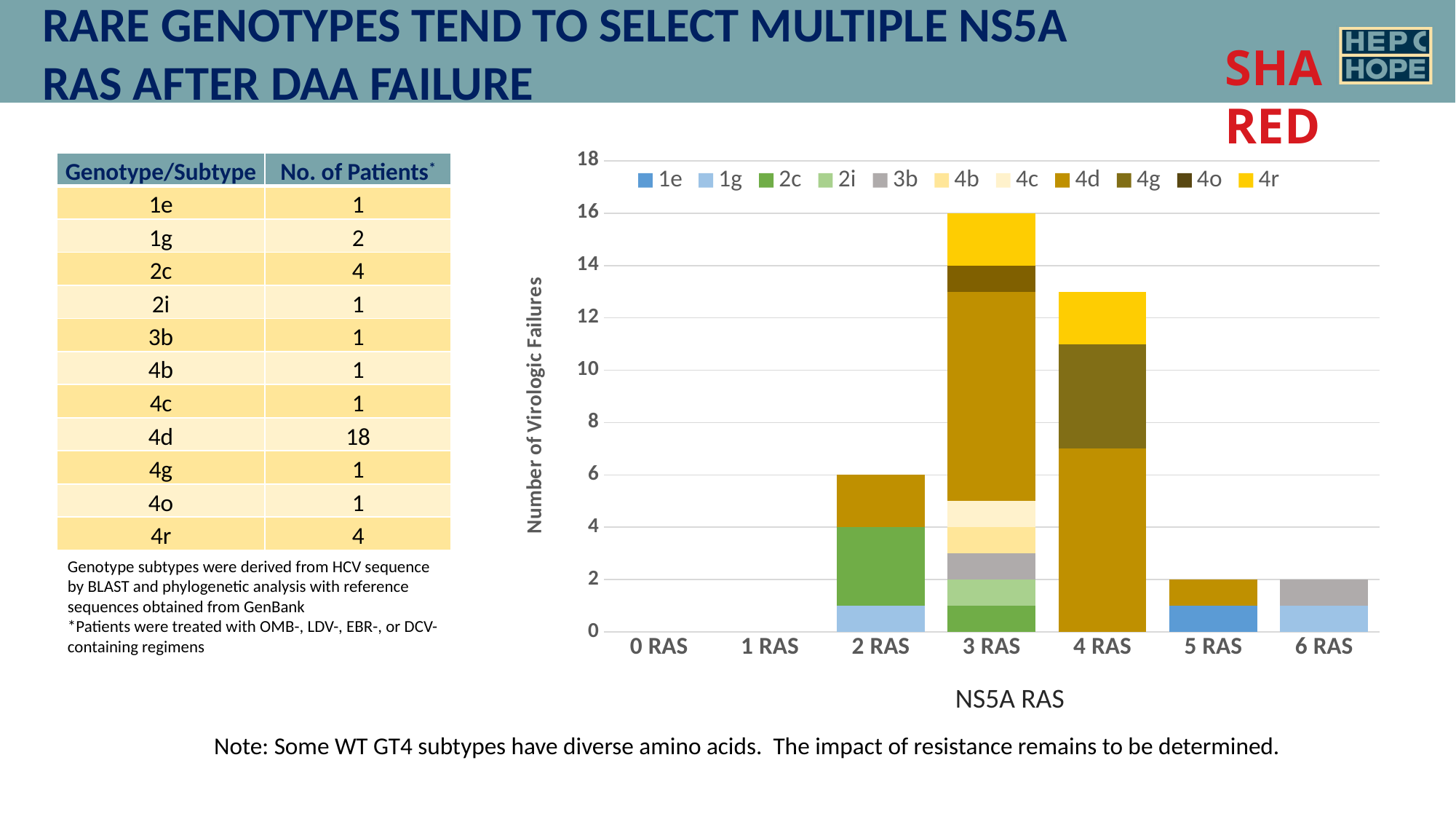
Which NS5A RAS category has the highest number of virologic failures? 3 RAS How many series does the chart legend list? 11 What is the total number of virologic failures for the 2 RAS bar? 6 What is the x-axis title of the chart? NS5A RAS Is the total for 6 RAS greater or less than 4? less What is the total number of virologic failures for the 3 RAS bar? 16 What type of chart is shown on the slide? stacked bar chart Is the total for 4 RAS greater or less than 12? greater Which bar is taller, 2 RAS or 4 RAS? 4 RAS What is the total number of virologic failures for the 5 RAS bar? 2 What is the y-axis title of the chart? Number of Virologic Failures How many NS5A RAS categories are shown on the x axis? 7